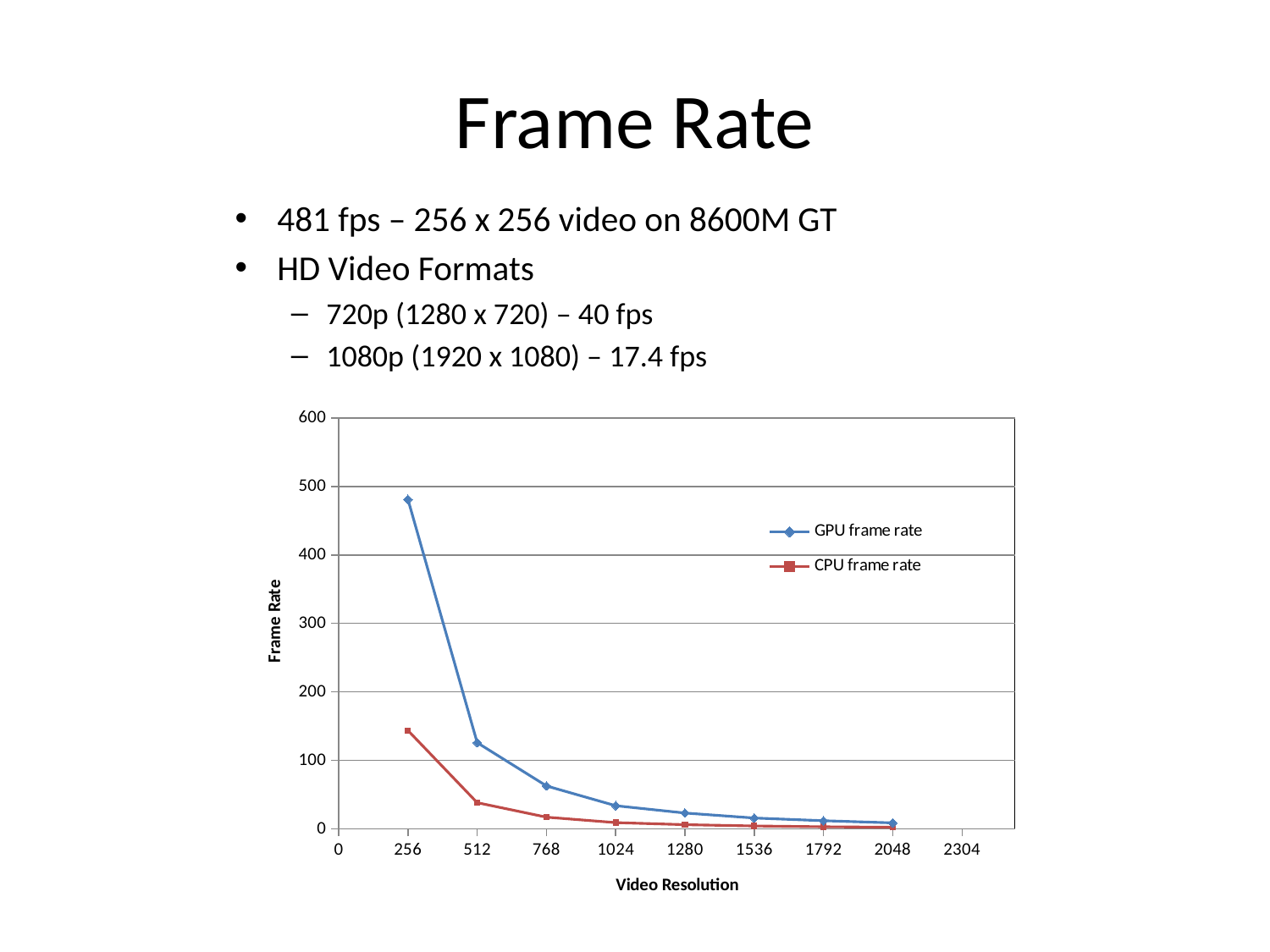
Is the CPU frame rate at a video resolution of 512 greater or less than 100? less What are the two series named in the chart's legend? GPU frame rate and CPU frame rate What kind of chart is shown on the slide? line chart At which video resolution is the GPU frame rate highest? 256 Is the CPU frame rate at a video resolution of 256 greater or less than 200? less What is the title of the chart's x axis? Video Resolution At a video resolution of 256, which series has the larger frame rate, GPU or CPU? GPU frame rate How many series does the chart's legend list? 2 How many data points are plotted for the GPU frame rate series? 8 Is the GPU frame rate at a video resolution of 512 greater or less than 100? greater Does the GPU frame rate rise or fall as video resolution increases? fall